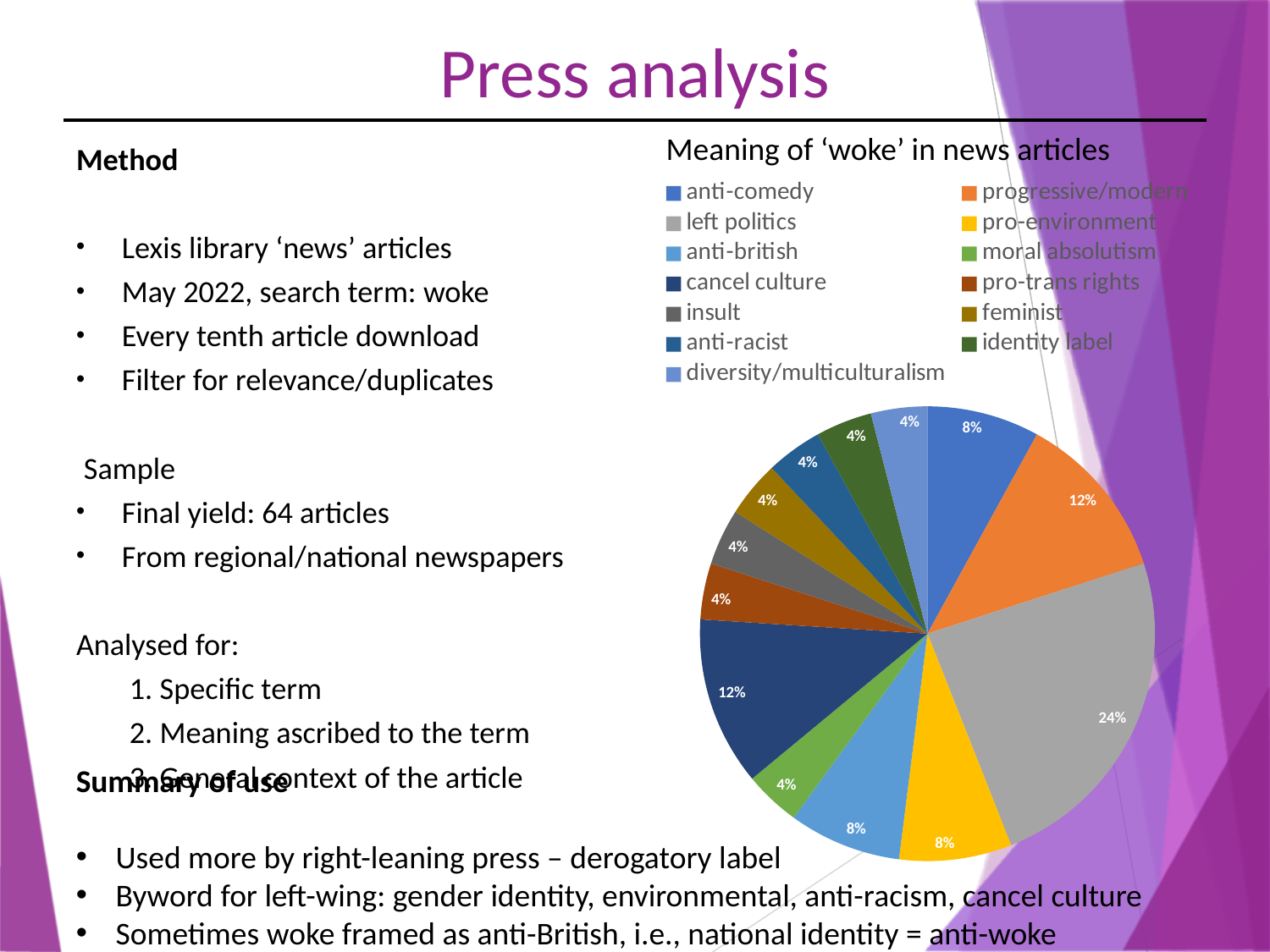
How many categories does the legend of the pie chart list? 13 What share of the pie does 'cancel culture' account for? 12% What is the combined share of the 'anti-comedy' and 'progressive/modern' slices? 20% What is the title of the chart? Meaning of 'woke' in news articles Which is larger, the 'progressive/modern' slice or the 'pro-environment' slice? progressive/modern What share of the pie does 'left politics' account for? 24% What share of the pie does 'progressive/modern' account for? 12% Which category has the largest share of the pie chart? left politics What kind of chart is shown on the slide? pie chart What is the smallest percentage shown on any slice of the pie chart? 4% What is the difference in percentage points between the 'left politics' slice and the 'cancel culture' slice? 12